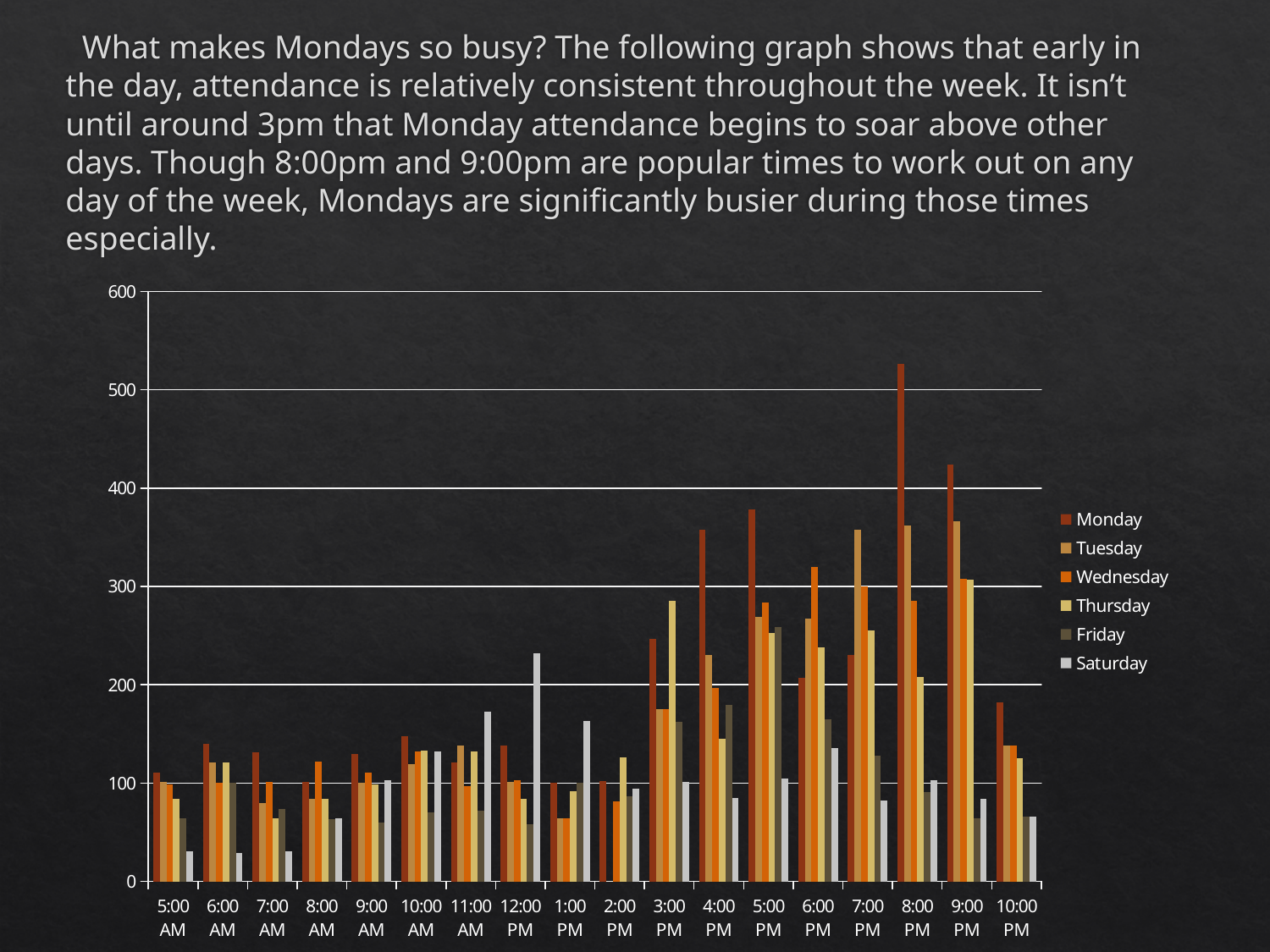
How many time categories are shown along the x axis? 18 How many series does the legend list? 6 Is the Monday value at 8:00 PM greater or less than 500? greater Which series is shown in light grey in the legend? Saturday Which day has the lowest bar at 5:00 AM? Saturday Is the Saturday value at 12:00 PM greater or less than 200? greater Which is larger, the Monday value at 8:00 PM or the Monday value at 9:00 PM? 8:00 PM At which time is the Monday value highest? 8:00 PM What kind of chart is shown on the slide? bar chart Is the Monday value at 5:00 PM greater or less than 400? less Which day has the highest bar at 12:00 PM? Saturday Which day has the highest bar at 8:00 PM? Monday